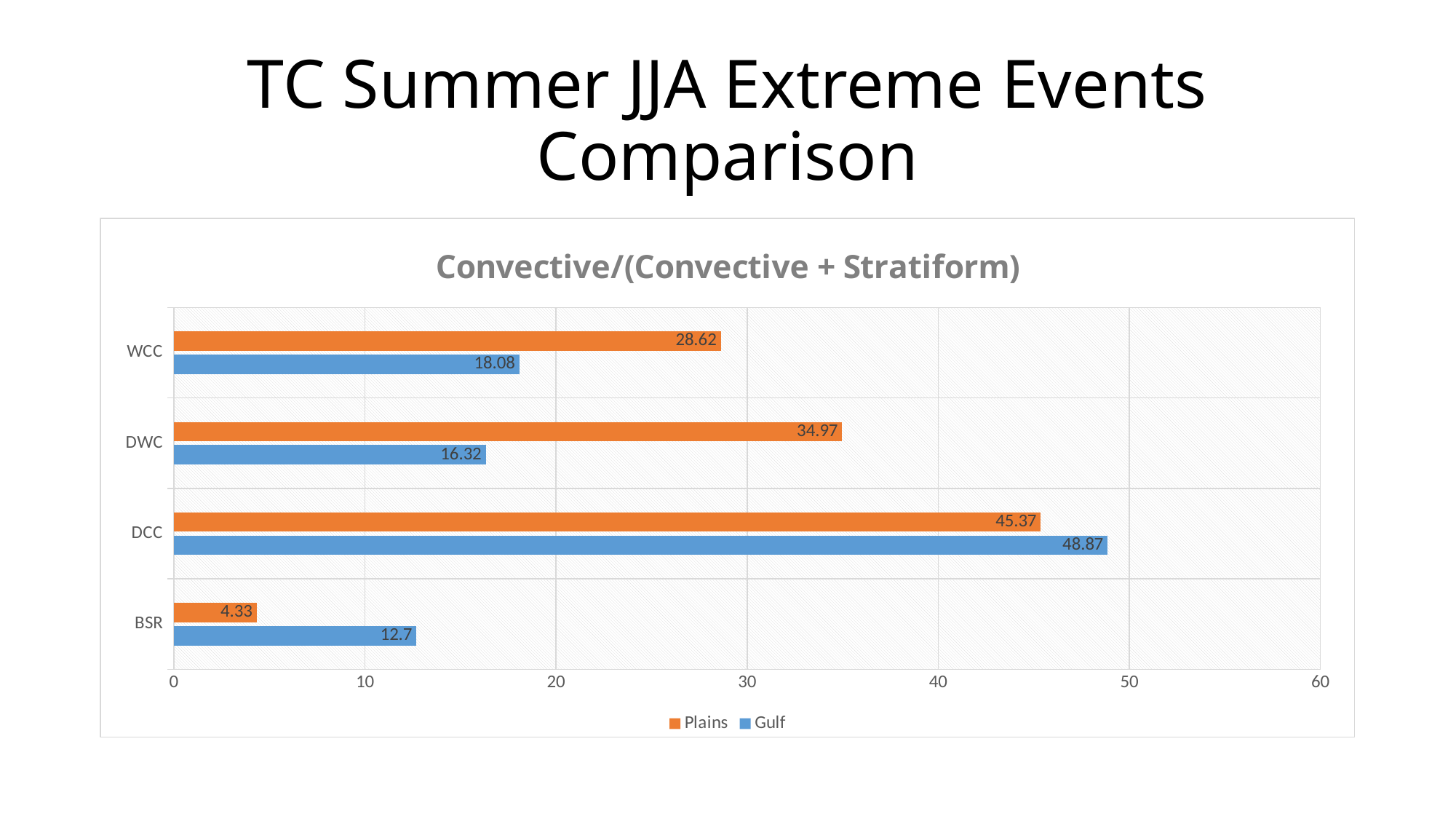
What is the difference between the Plains and Gulf values for DWC? 18.65 What is the Gulf value for WCC? 18.08 What kind of chart is shown on the slide? bar chart Which category has the highest Gulf value? DCC Which category has the lowest Plains value? BSR For DCC, which series has the larger value, Plains or Gulf? Gulf What is the Plains value for DCC? 45.37 What is the title of the chart? Convective/(Convective + Stratiform) What is the Gulf value for BSR? 12.7 Is the Plains value for WCC greater or less than 20? greater How many categories are shown on the chart? 4 How many series does the legend list? 2